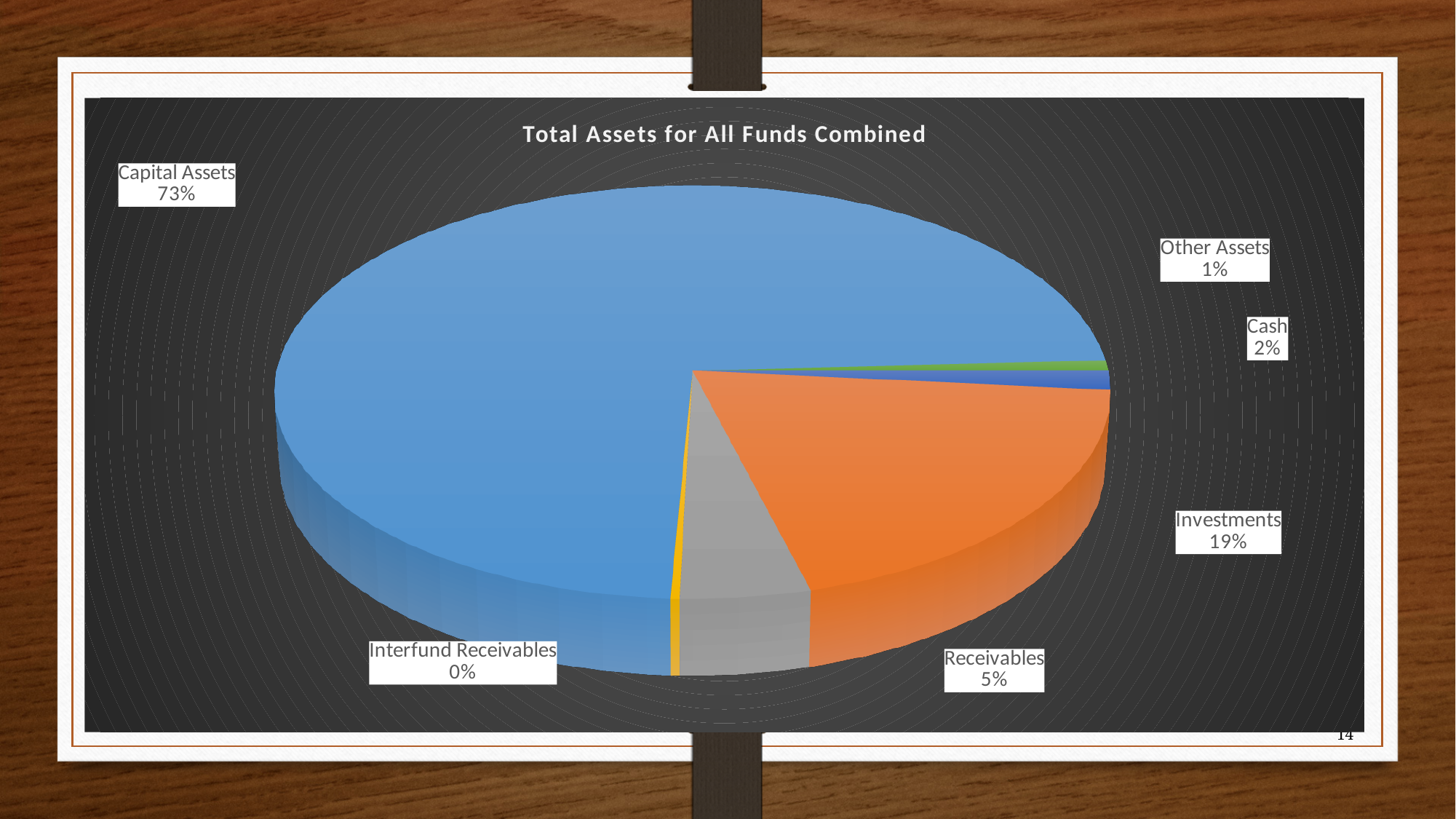
What percentage is shown for Other Assets? 1% Which category has the largest share of the pie? Capital Assets Which category has the smallest share of the pie? Interfund Receivables What percentage does Investments represent in the pie chart? 19% What percentage is shown for Interfund Receivables? 0% What type of chart is shown on the slide? Pie chart Which is larger, Receivables or Cash? Receivables What percentage is shown for Cash? 2% What is the difference in percentage points between Capital Assets and Investments? 54 How many categories are shown in the pie chart? 6 What is the value shown for Receivables? 5% What share of total assets is Capital Assets? 73%